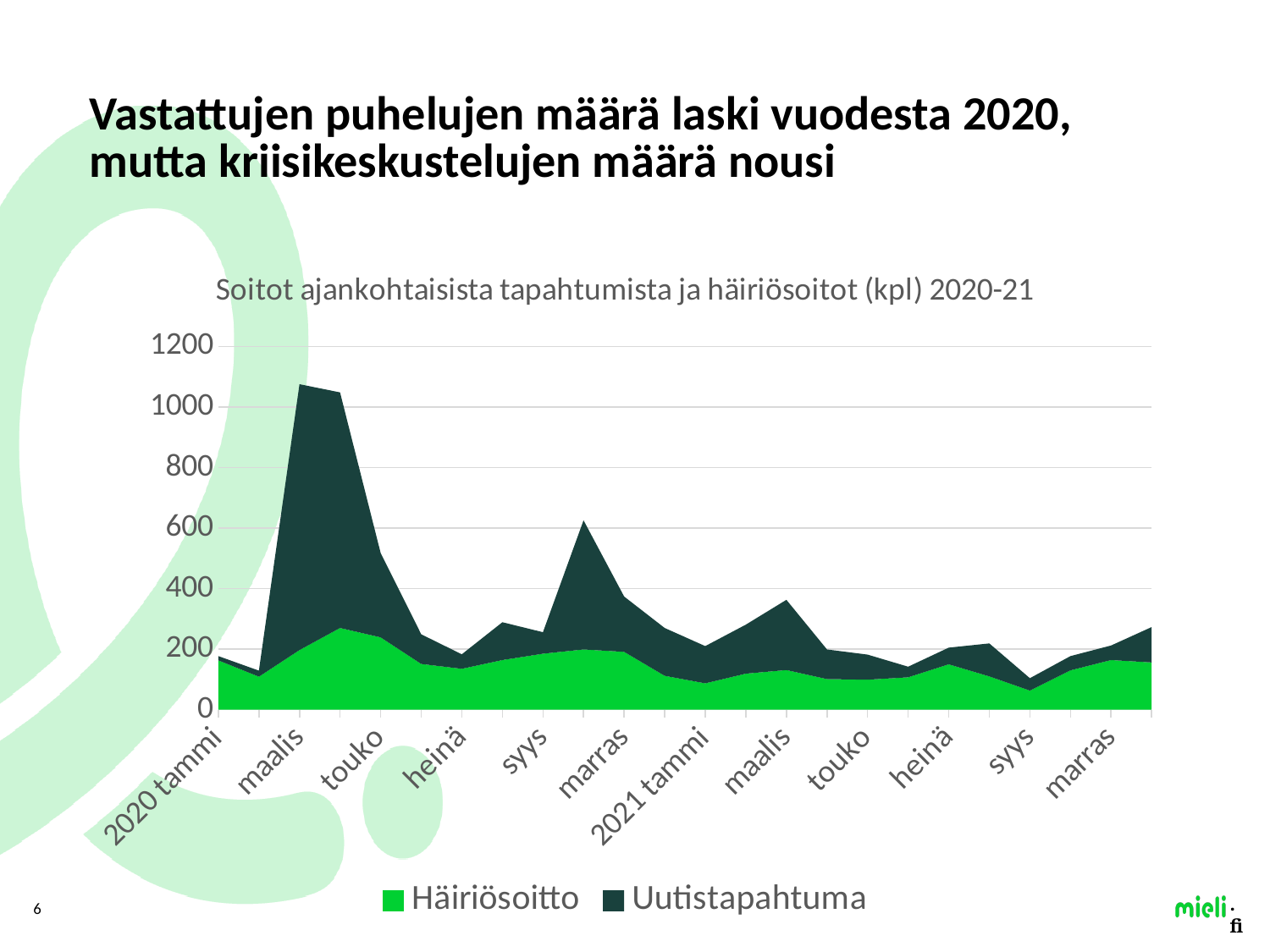
Is the value for Häiriösoitto at 2020 touko greater or less than 200? greater Is the value for Häiriösoitto at 2021 touko greater or less than 200? less What is the title of the chart? Soitot ajankohtaisista tapahtumista ja häiriösoitot (kpl) 2020-21 How many month labels are shown on the x axis? 12 Is the stacked total higher at 2020 maalis or at 2021 maalis? 2020 maalis Is the stacked total at 2020 marras greater or less than 400? less How many series does the legend list? 2 Which two series are listed in the chart legend? Häiriösoitto and Uutistapahtuma What kind of chart is shown on the slide? area chart At which month does the stacked total reach its highest value? 2020 maalis